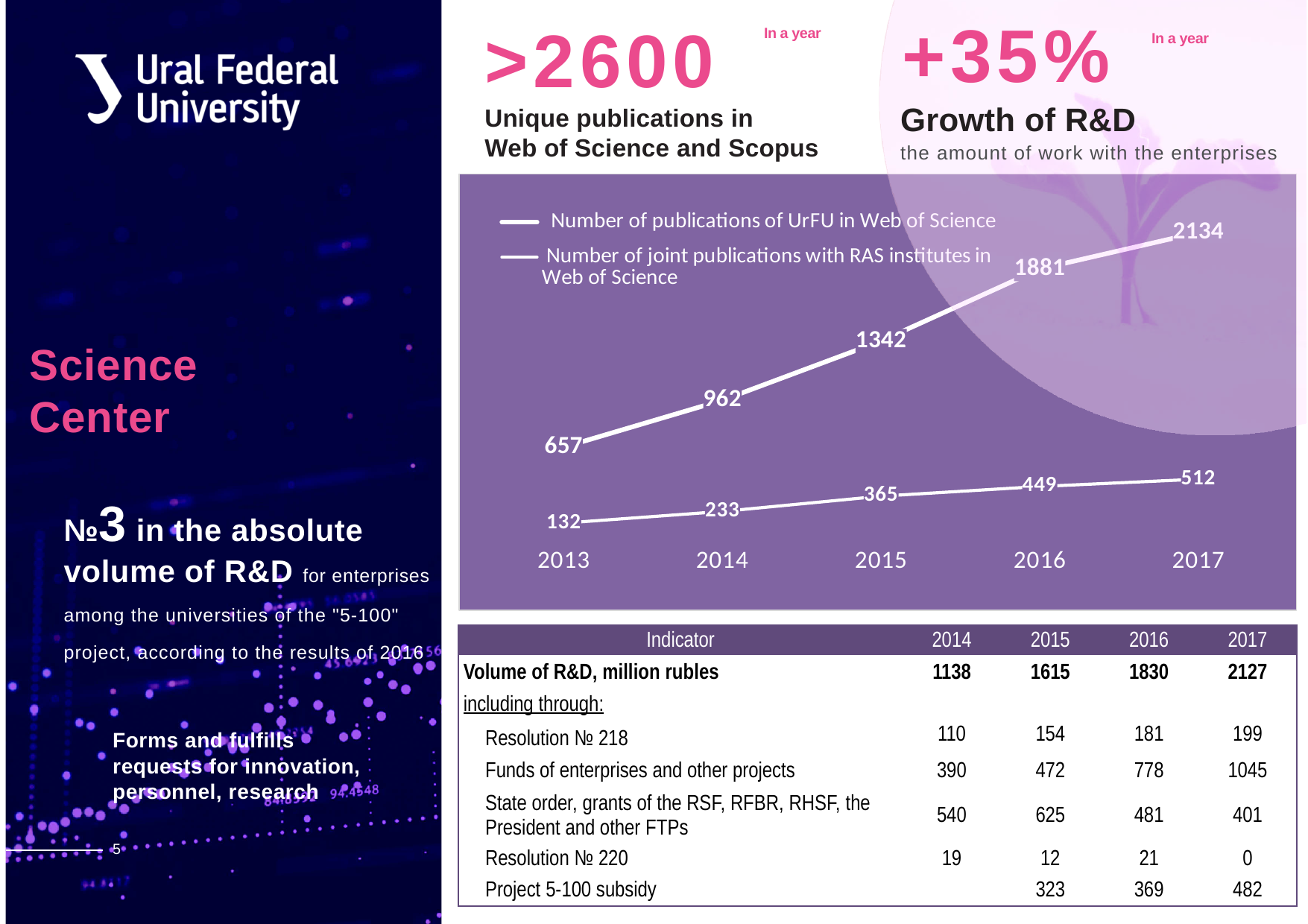
What is the number of publications of UrFU in Web of Science in 2013? 657 In which year is the number of publications of UrFU in Web of Science highest? 2017 What is the number of publications of UrFU in Web of Science in 2015? 1342 How many series does the chart legend list? 2 In which year is the number of joint publications with RAS institutes in Web of Science lowest? 2013 What type of chart is shown on the slide? line chart What is the difference between the number of publications of UrFU in Web of Science in 2017 and in 2016? 253 How many years are shown on the x axis of the chart? 5 What is the difference between the number of publications of UrFU in Web of Science and the number of joint publications with RAS institutes in 2017? 1622 Which is larger: the number of joint publications with RAS institutes in 2017 or the number of publications of UrFU in Web of Science in 2013? Number of publications of UrFU in Web of Science in 2013 What is the number of joint publications with RAS institutes in Web of Science in 2016? 449 Does the number of publications of UrFU in Web of Science rise or fall from 2013 to 2017? rise